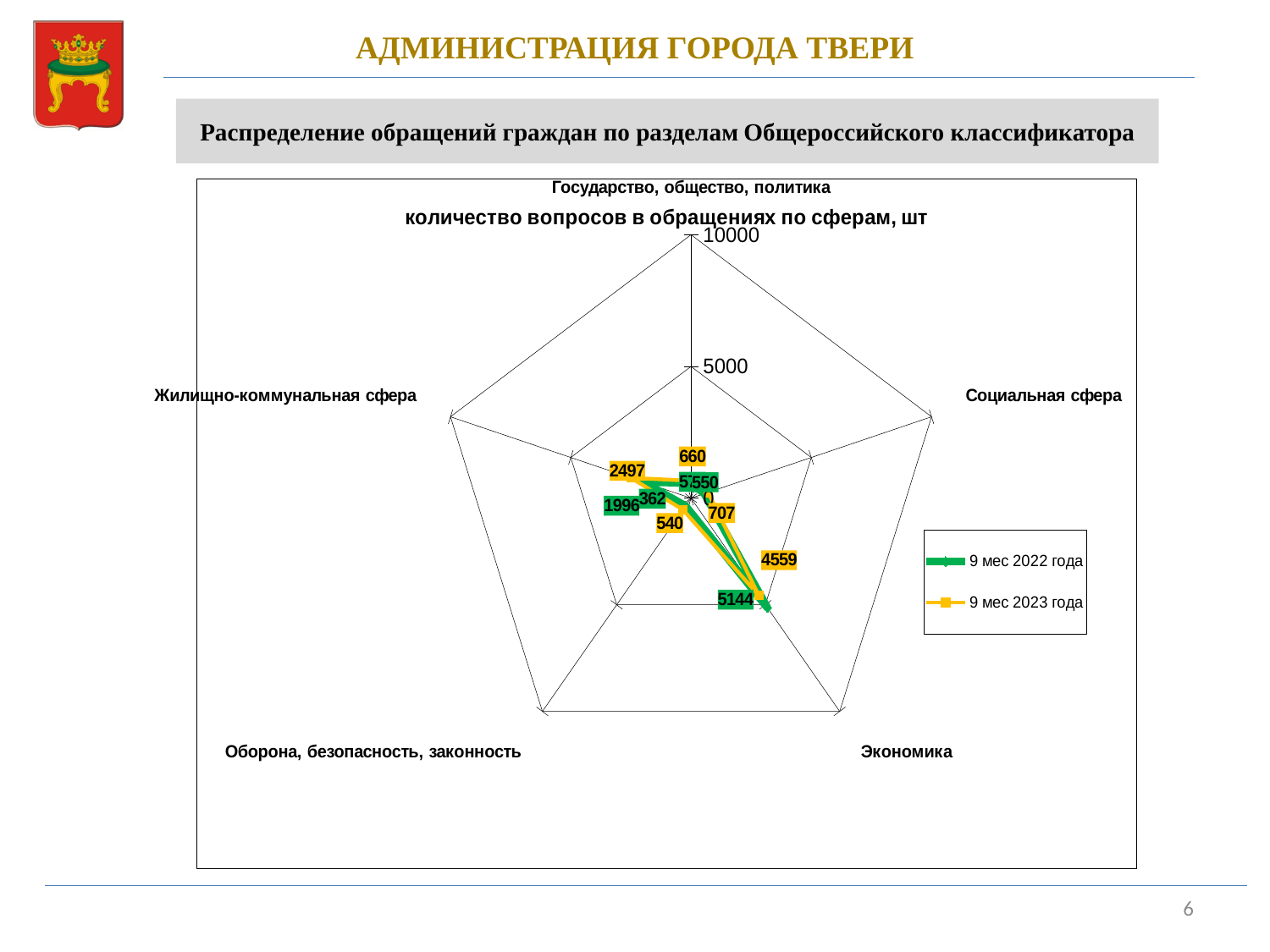
What is the value for Оборона, безопасность, законность in the 9 мес 2022 года series? 362 How many categories (axes) does the chart have? 5 What is the difference between the 9 мес 2023 года and 9 мес 2022 года values for Жилищно-коммунальная сфера? 501 What is the value for Экономика in the 9 мес 2023 года series? 4559 Is the value for Экономика in the 9 мес 2023 года series greater or less than 5000? less Which category has the highest value in the 9 мес 2022 года series? Экономика What is the value for Экономика in the 9 мес 2022 года series? 5144 What is the value for Государство, общество, политика in the 9 мес 2023 года series? 660 What is the difference between the 9 мес 2022 года and 9 мес 2023 года values for Экономика? 585 What is the value for Жилищно-коммунальная сфера in the 9 мес 2023 года series? 2497 What kind of chart is shown on the slide? radar chart For Оборона, безопасность, законность, which series has the larger value: 9 мес 2022 года or 9 мес 2023 года? 9 мес 2023 года